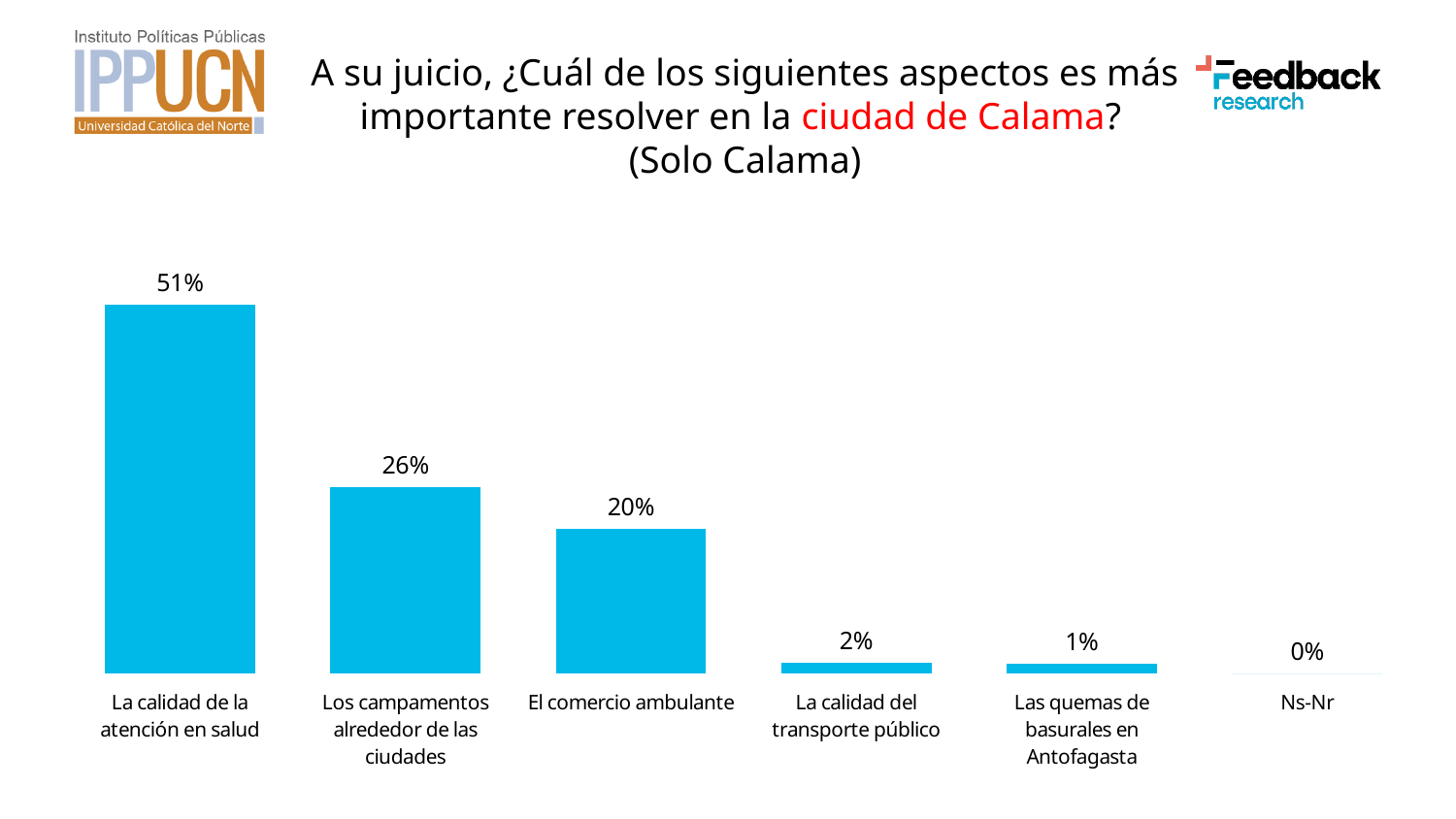
How many categories are shown in the chart? 6 What kind of chart is shown on the slide? Bar chart Which is larger, the value for "El comercio ambulante" or the value for "La calidad del transporte público"? El comercio ambulante What is the value for "La calidad de la atención en salud"? 51% What is the value for "Los campamentos alrededor de las ciudades"? 26% Which category has the highest value? La calidad de la atención en salud What is the value for "Ns-Nr"? 0% What is the value for "La calidad del transporte público"? 2% What is the difference between the values for "La calidad de la atención en salud" and "Los campamentos alrededor de las ciudades"? 25% Do the values rise or fall from left to right across the categories? Fall Which category has the lowest value? Ns-Nr What is the value for "El comercio ambulante"? 20%